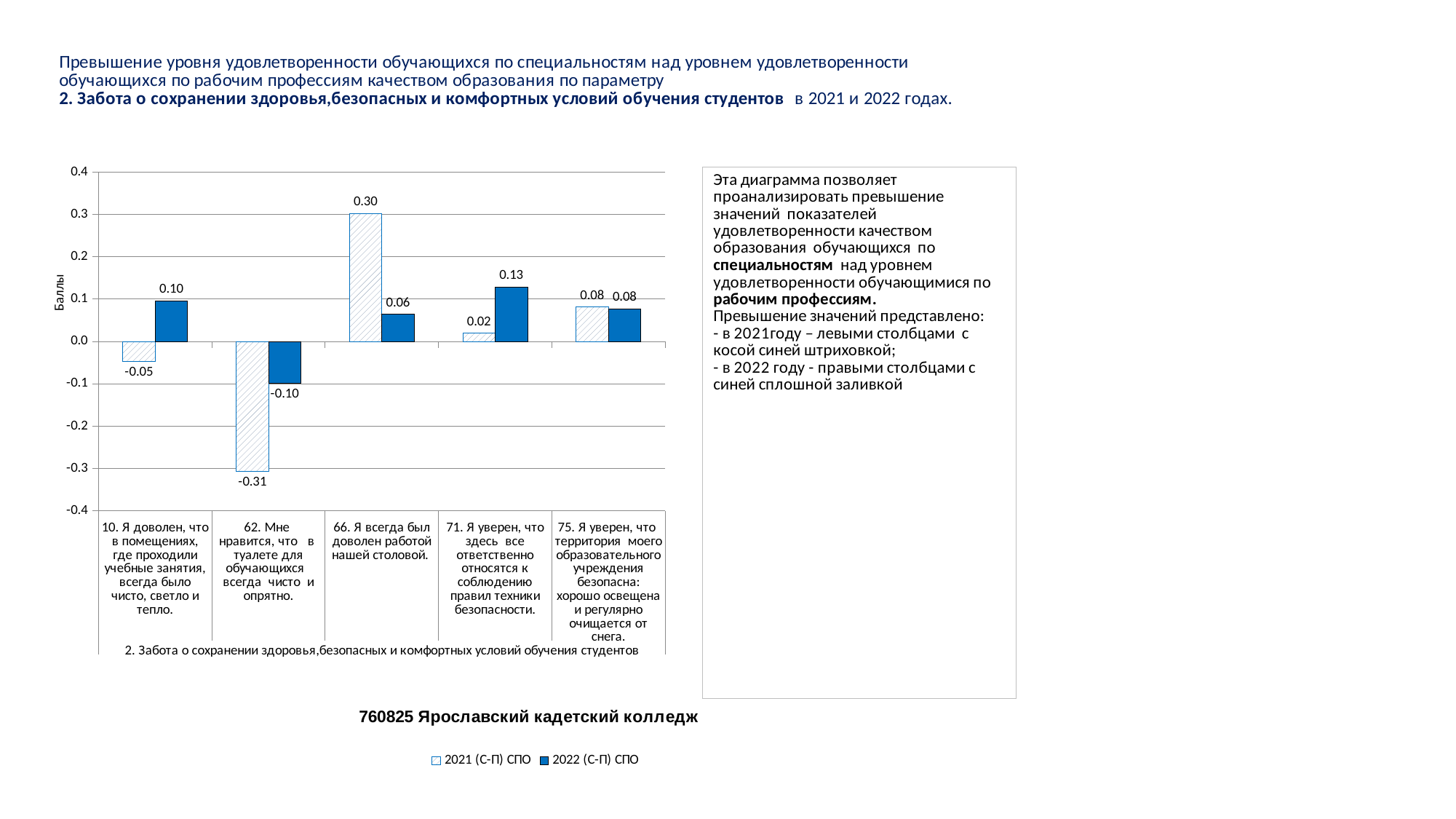
What is the 2021 (С-П) СПО value for category 66 (Я всегда был доволен работой нашей столовой)? 0.30 How many categories are shown on the x axis of the chart? 5 What is the 2021 (С-П) СПО value for category 10 (Я доволен, что в помещениях, где проходили учебные занятия, всегда было чисто, светло и тепло)? -0.05 For category 71, which series has the larger value: 2021 (С-П) СПО or 2022 (С-П) СПО? 2022 (С-П) СПО What is the difference between the 2021 and 2022 (С-П) СПО values for category 66? 0.24 Is the 2021 (С-П) СПО value for category 62 greater or less than -0.3? less What is the 2022 (С-П) СПО value for category 62 (Мне нравится, что в туалете для обучающихся всегда чисто и опрятно)? -0.10 What is the label of the y axis of the chart? Баллы What type of chart is shown on the slide? bar chart How many series does the chart legend list? 2 Which category has the lowest 2021 (С-П) СПО value? 62. Мне нравится, что в туалете для обучающихся всегда чисто и опрятно. Which category has the highest 2022 (С-П) СПО value? 71. Я уверен, что здесь все ответственно относятся к соблюдению правил техники безопасности.